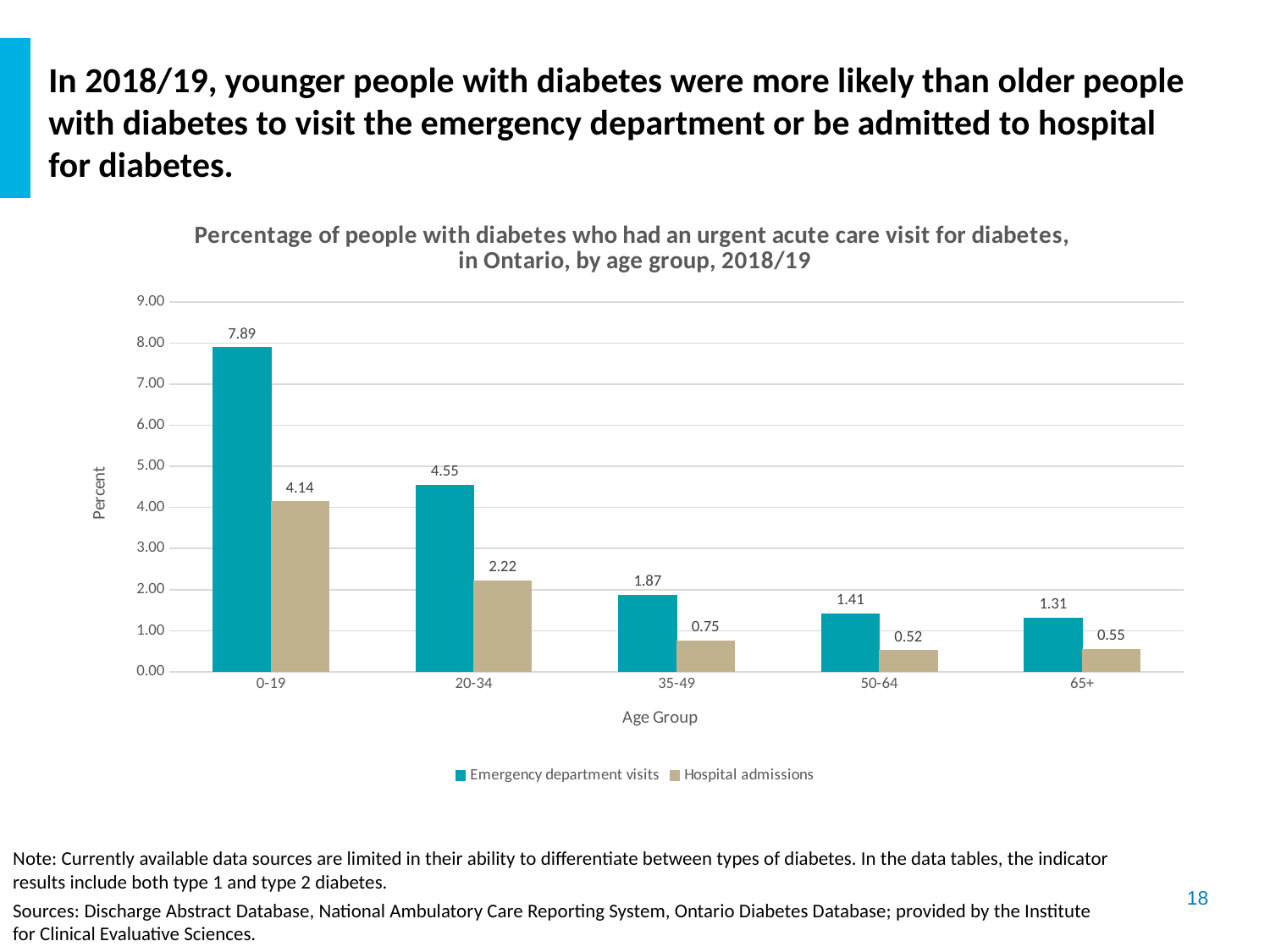
Which age group has the lowest value for Hospital admissions? 50-64 Do the Emergency department visits values rise or fall as age group increases along the x axis? Fall How many series does the legend list? 2 What kind of chart is shown on the slide? Bar chart What is the value for Emergency department visits in the 0-19 age group? 7.89 What is the value for Hospital admissions in the 65+ age group? 0.55 How many age groups are shown on the x axis? 5 Which is larger in the 35-49 age group: Emergency department visits or Hospital admissions? Emergency department visits What is the difference between Emergency department visits and Hospital admissions in the 0-19 age group? 3.75 What is the value for Hospital admissions in the 20-34 age group? 2.22 Which age group has the highest value for Emergency department visits? 0-19 Is the value for Emergency department visits in the 20-34 age group greater or less than 4.00? greater